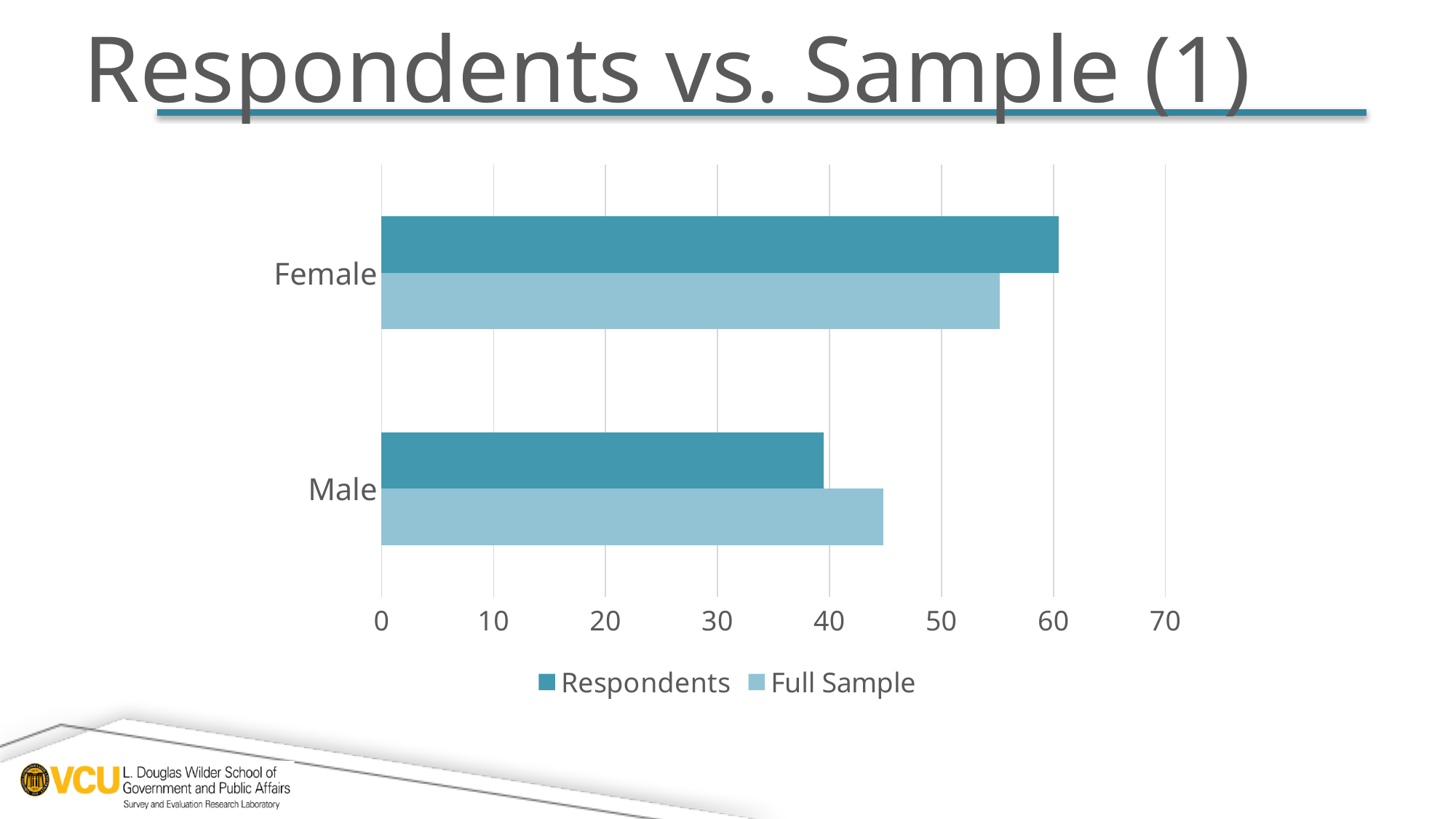
Is the Full Sample value for Male greater or less than 50? less What is the title of the slide containing the chart? Respondents vs. Sample (1) How many categories are shown on the chart? 2 For Female, which series has the larger value, Respondents or Full Sample? Respondents What kind of chart is shown on the slide? bar chart How many series does the legend list? 2 For Male, which series has the larger value, Respondents or Full Sample? Full Sample Is the Respondents value for Male greater or less than 30? greater Which bar on the chart is the longest? Female, Respondents Which bar on the chart is the shortest? Male, Respondents Which two series are listed in the legend? Respondents and Full Sample Is the Respondents value for Female greater or less than 50? greater